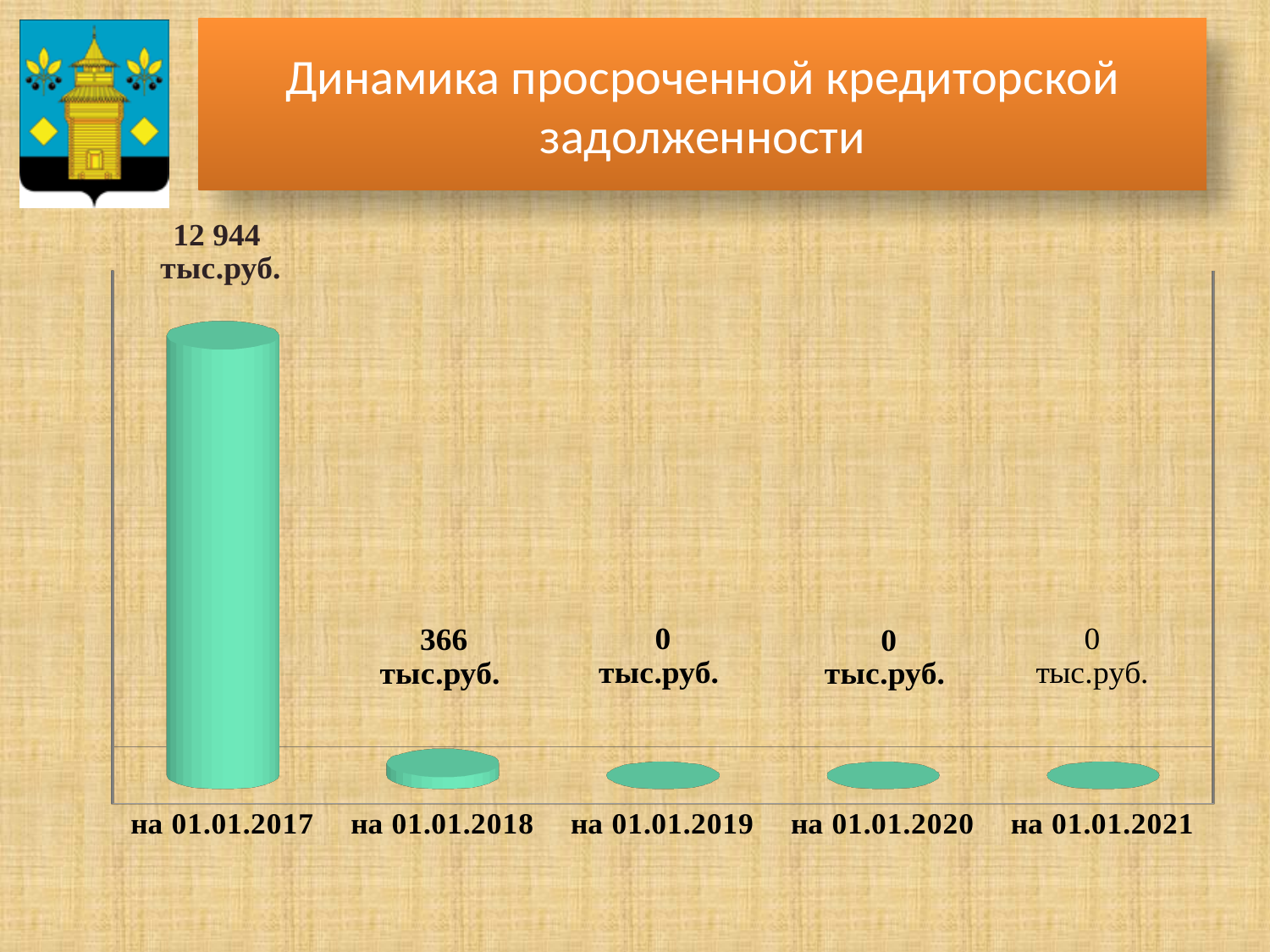
Which is larger, the value for на 01.01.2018 or the value for на 01.01.2020? на 01.01.2018 What is the difference between the values for на 01.01.2017 and на 01.01.2018? 12 578 тыс.руб. What is the value for на 01.01.2021? 0 тыс.руб. What is the title of the chart? Динамика просроченной кредиторской задолженности What is the value for на 01.01.2018? 366 тыс.руб. How many categories have a value of 0 тыс.руб.? 3 What is the value for на 01.01.2017? 12 944 тыс.руб. Do the values rise or fall from на 01.01.2017 to на 01.01.2021? fall What kind of chart is shown on the slide? bar chart What is the value for на 01.01.2019? 0 тыс.руб. How many categories are shown on the chart? 5 Which category has the highest value? на 01.01.2017